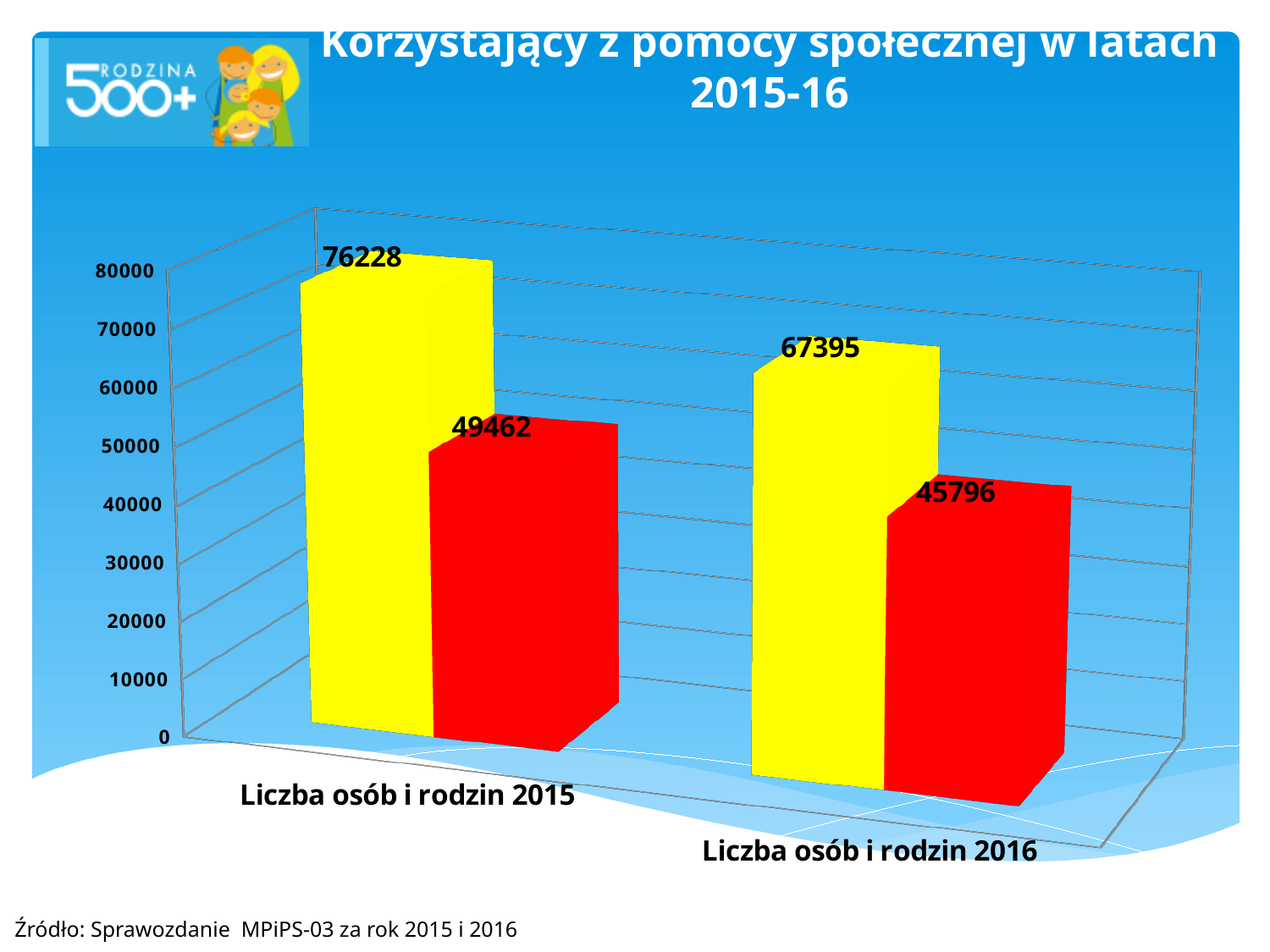
Which is larger: the yellow bar for 2016 or the red bar for 2015? The yellow bar for 2016 What is the value of the yellow bar for "Liczba osób i rodzin 2015"? 76228 What is the value of the red bar for "Liczba osób i rodzin 2015"? 49462 What kind of chart is shown on the slide? Bar chart Which bar has the highest value on the chart? The yellow bar for Liczba osób i rodzin 2015 (76228) By how much does the yellow bar decrease from 2015 to 2016? 8833 How many categories are shown on the x axis? 2 Do the red bar values rise or fall from 2015 to 2016? Fall What is the difference between the yellow and red bars for "Liczba osób i rodzin 2015"? 26766 Which bar has the lowest value on the chart? The red bar for Liczba osób i rodzin 2016 (45796) What is the value of the yellow bar for "Liczba osób i rodzin 2016"? 67395 What is the value of the red bar for "Liczba osób i rodzin 2016"? 45796